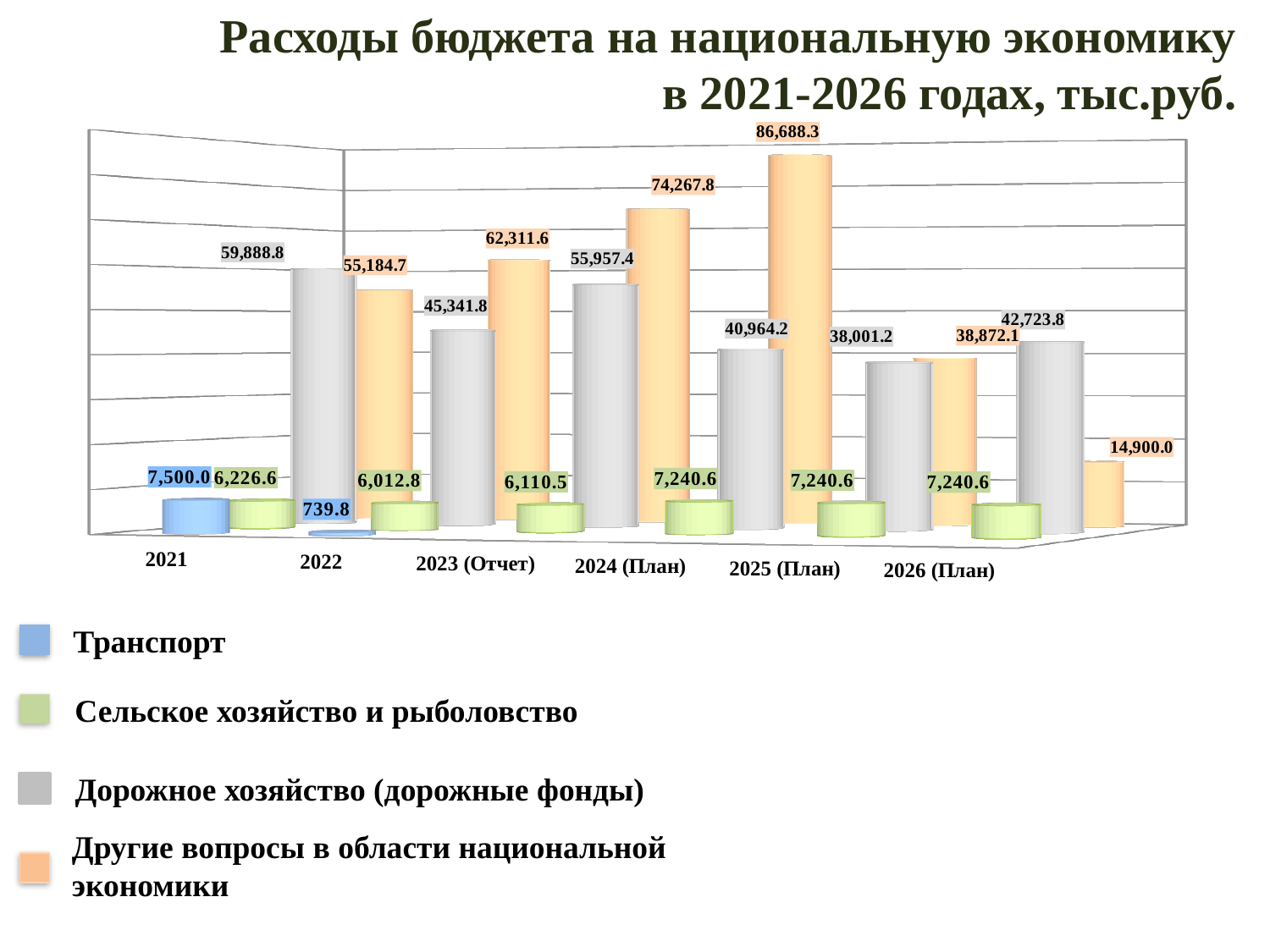
What is the difference between the Транспорт values for 2021 and 2022? 6,760.2 What is the lowest value labeled for Другие вопросы в области национальной экономики? 14,900.0 What is the value for Транспорт in 2021? 7,500.0 What type of chart is shown on the slide? Bar chart How many year categories are shown on the x axis? 6 What is the value for Сельское хозяйство и рыболовство in 2021? 6,226.6 What is the highest value labeled on the chart? 86,688.3 What is the value for Транспорт in 2022? 739.8 Which is larger: the bar labeled 86,688.3 or the bar labeled 74,267.8? 86,688.3 Which series has the tallest bar on the chart? Другие вопросы в области национальной экономики What is the highest value labeled for Дорожное хозяйство (дорожные фонды)? 59,888.8 How many series does the legend list? 4